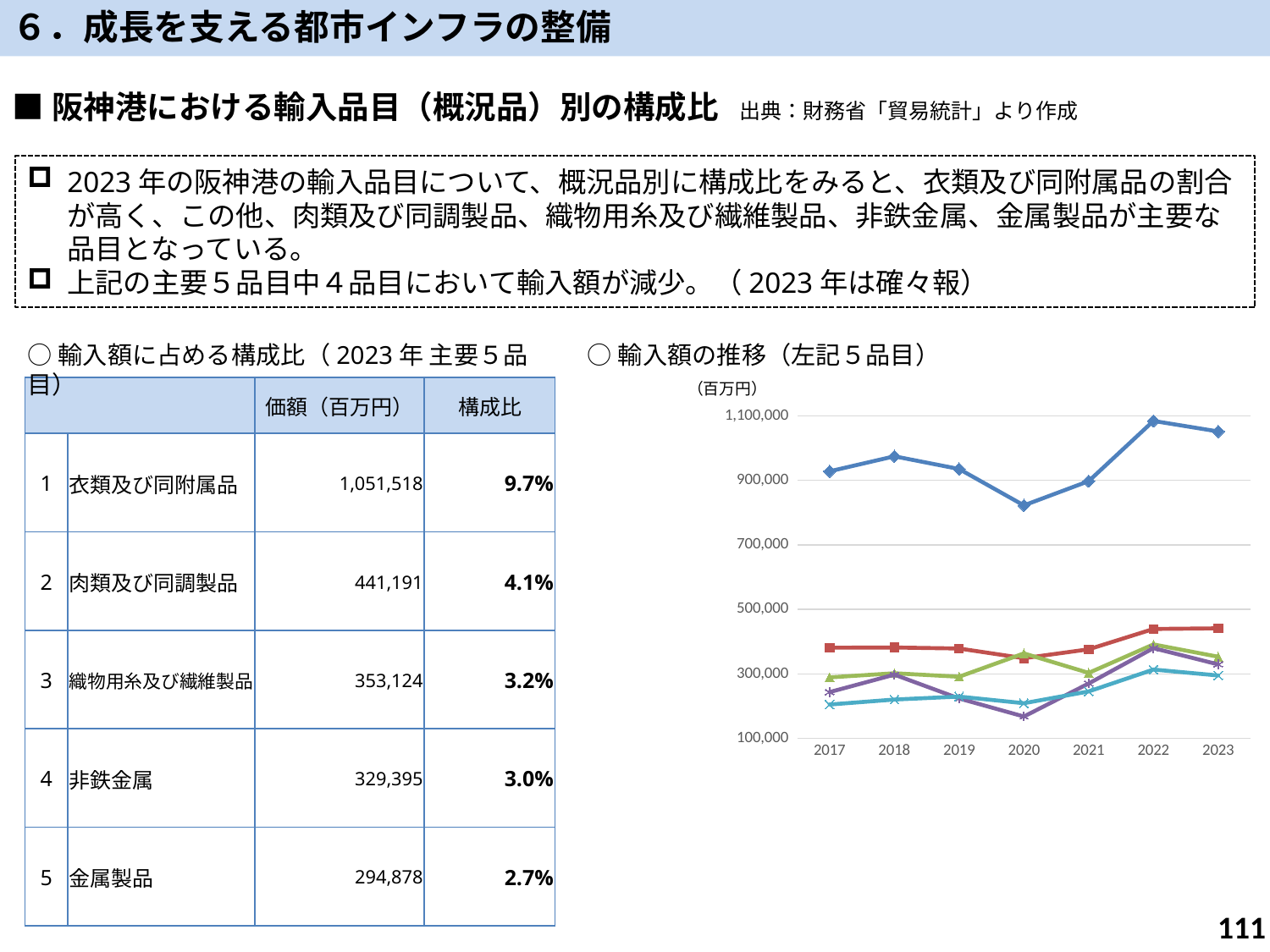
In the 「輸入額の推移」 chart, is the value of the blue (top) line in 2020 greater or less than 900,000? less In the 「輸入額の推移」 chart, is the value of the red line in 2022 greater or less than 500,000? less In the 「輸入額の推移」 chart, how many lines are plotted? 5 In the 「輸入額の推移」 chart, what unit is shown above the y axis? 百万円 In the 「輸入額の推移」 chart, is the blue (top) line higher in 2022 or in 2023? 2022 In the 「輸入額の推移」 chart, in which year does the blue (top) line reach its lowest point? 2020 In the 「輸入額の推移」 chart, what is the first year on the x axis? 2017 What kind of chart is shown under 「輸入額の推移（左記５品目）」? line chart In the 「輸入額の推移」 chart, is the value of the blue (top) line in 2022 greater or less than 900,000? greater In the 「輸入額の推移」 chart, does the blue (top) line rise or fall from 2020 to 2022? rise In the 「輸入額の推移」 chart, in which year does the blue (top) line reach its highest point? 2022 In the 「輸入額の推移」 chart, how many years are shown on the x axis? 7